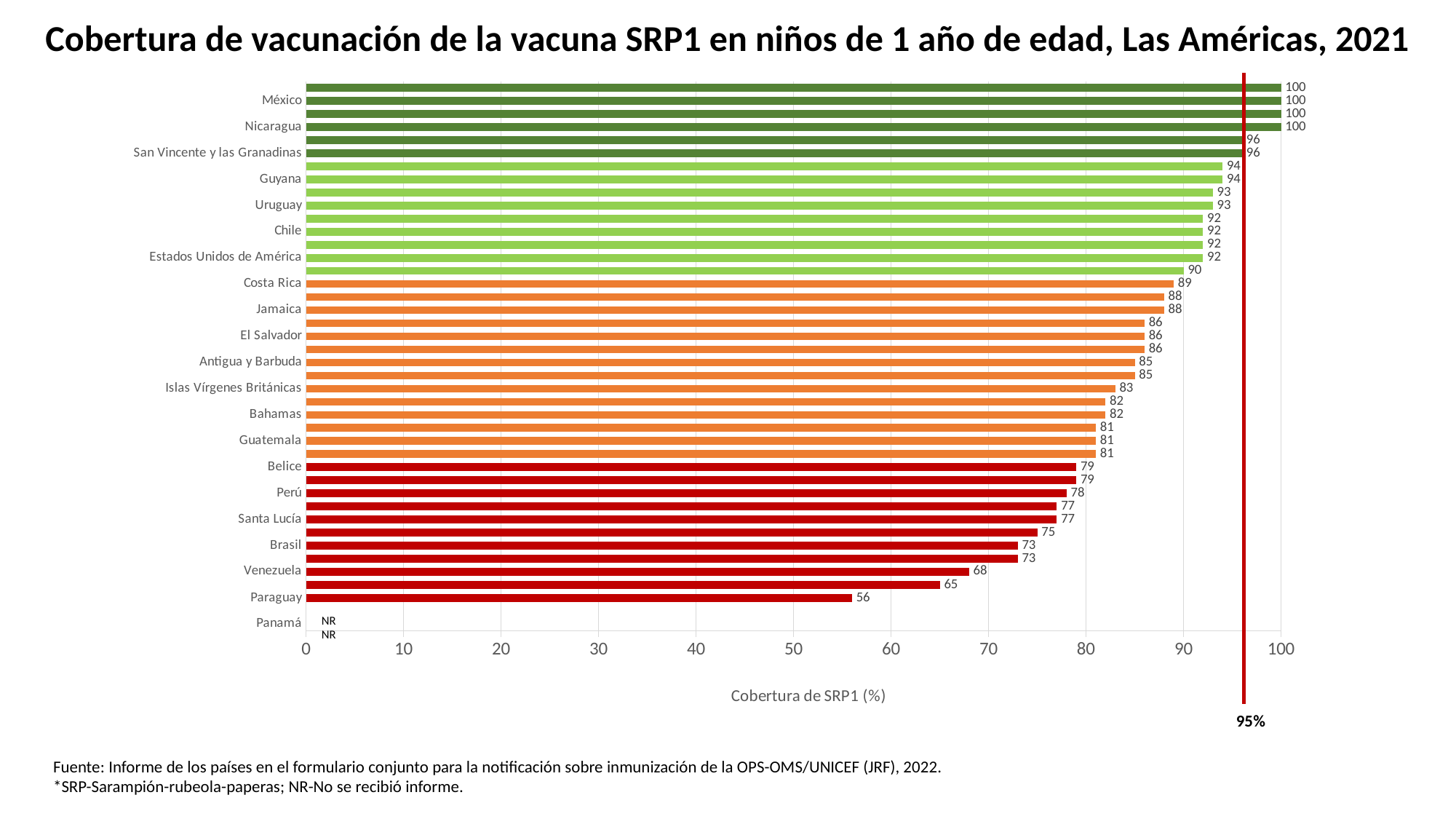
What is the SRP1 coverage value shown for Brasil? 73 What is the SRP1 coverage value shown for Uruguay? 93 What is the SRP1 coverage value shown for Paraguay? 56 What is the SRP1 coverage value shown for Venezuela? 68 Which has higher SRP1 coverage, Guyana or Perú? Guyana What kind of chart is shown on the slide? Bar chart What percentage does the red vertical line on the chart mark? 95% What is the difference between the SRP1 coverage of Chile and Brasil? 19 What is the title of the horizontal axis? Cobertura de SRP1 (%) What value is shown for Panamá? NR Is the value for Venezuela greater or less than 70? less Which labelled country has the lowest reported SRP1 coverage? Paraguay